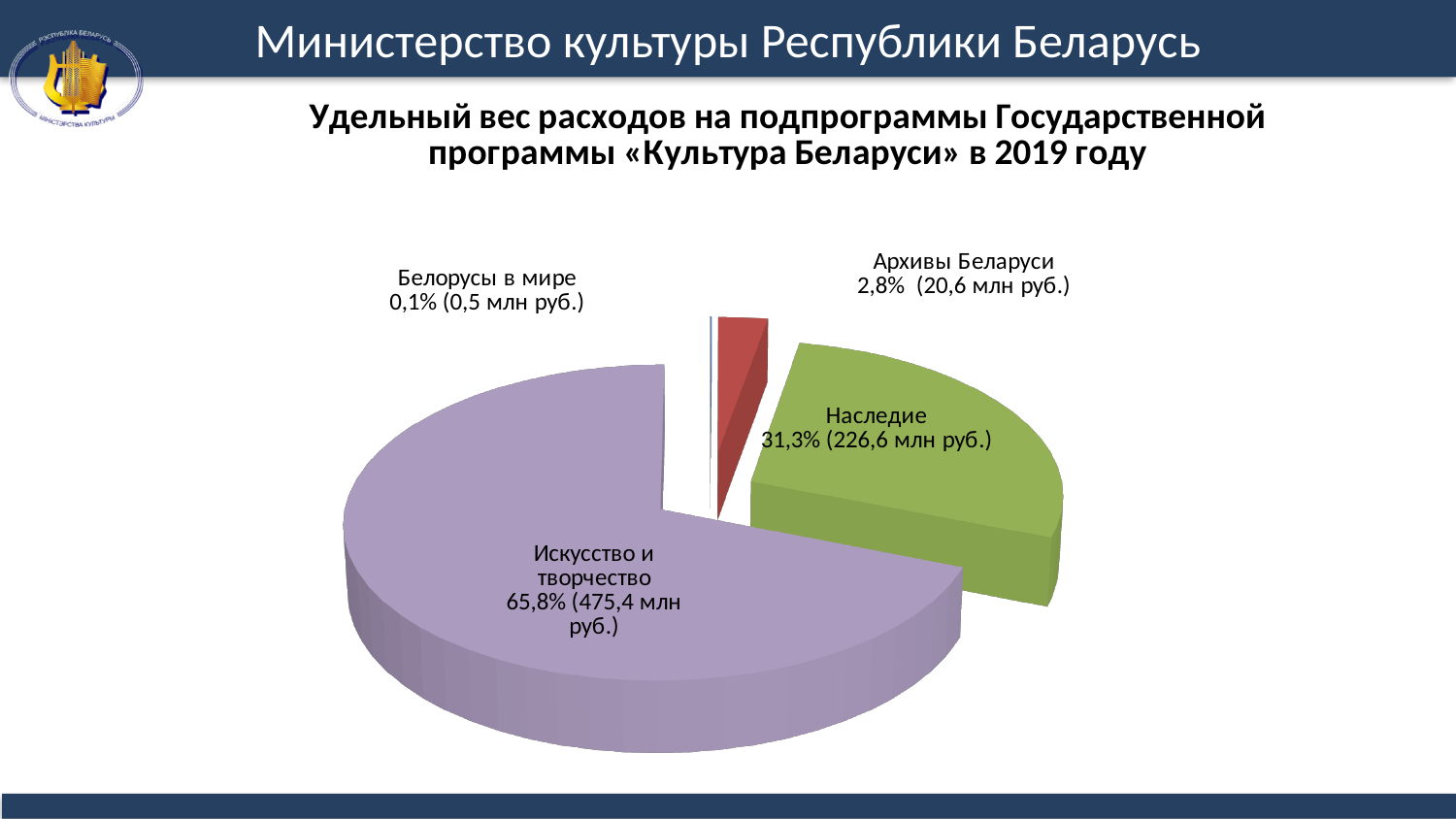
What kind of chart is shown on the slide? pie chart What is the amount in million rubles for «Архивы Беларуси»? 20,6 млн руб. Which is larger, the share for «Наследие» or the share for «Архивы Беларуси»? Наследие How many slices does the pie chart have? 4 Which subprogramme has the largest share of expenditure? Искусство и творчество Which subprogramme has the smallest share of expenditure? Белорусы в мире What share of expenditure does «Белорусы в мире» represent? 0,1% What is the difference in million rubles between «Архивы Беларуси» and «Белорусы в мире»? 20,1 млн руб. What share of expenditure does the «Наследие» slice represent? 31,3% What is the amount in million rubles for «Искусство и творчество»? 475,4 млн руб. What is the difference in percentage points between «Искусство и творчество» and «Наследие»? 34,5 What colour is the «Наследие» slice? green